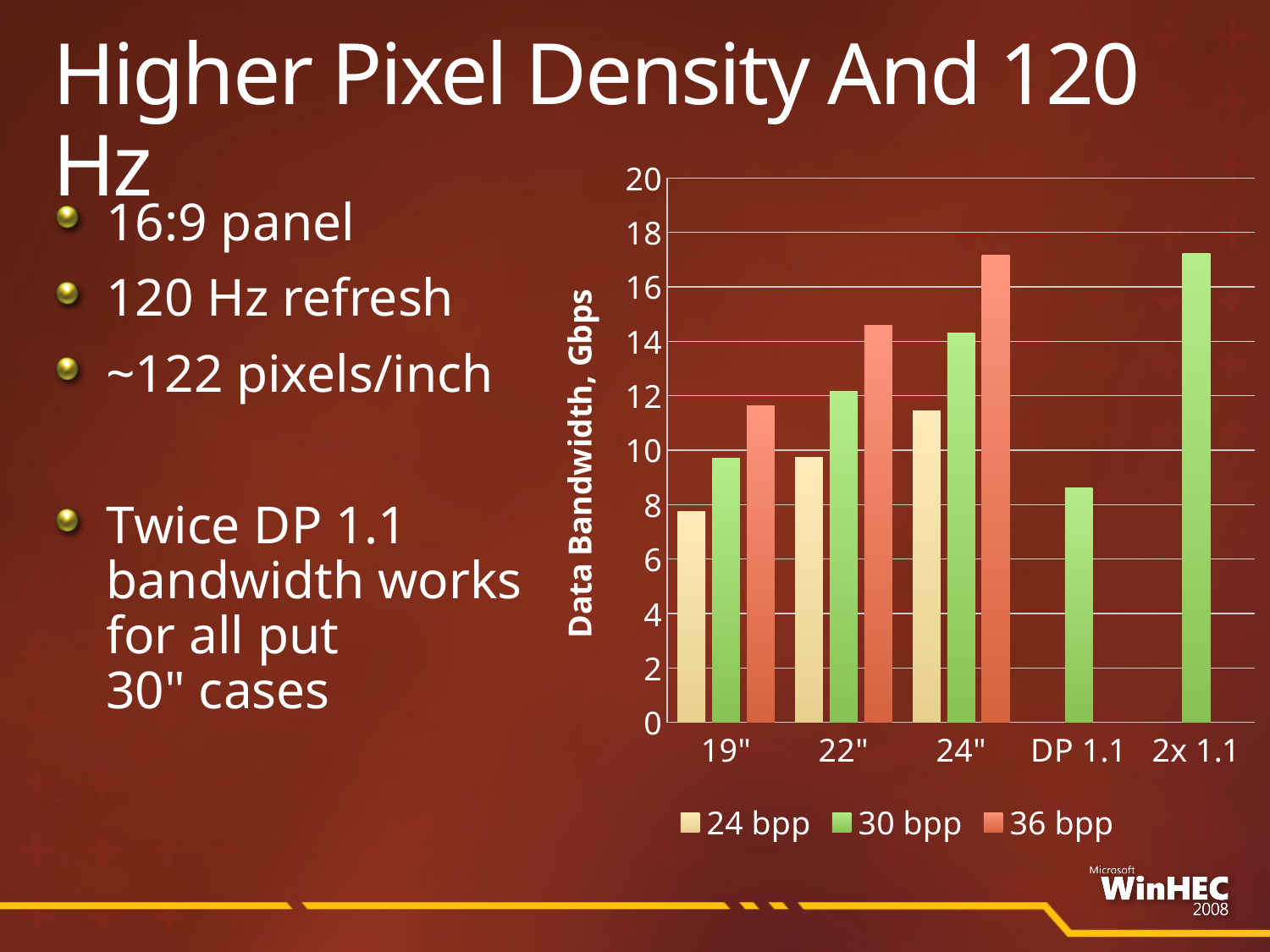
Which is larger: the 36 bpp value for 22" or the 24 bpp value for 24"? 36 bpp value for 22" Is the value for DP 1.1 greater or less than 10? less What is the title of the vertical axis of the chart? Data Bandwidth, Gbps How many series does the chart legend list? 3 Do the 36 bpp values rise or fall from 19" to 24"? rise Among the 19", 22" and 24" categories, which has the lowest 24 bpp value? 19" What kind of chart is shown on the slide? bar chart Which series in the chart is shown in green? 30 bpp Among the 19", 22" and 24" categories, which has the highest 36 bpp value? 24" Is the 36 bpp value for 24" greater or less than 16? greater How many categories are shown on the x axis of the chart? 5 Is the 24 bpp value for 19" greater or less than 10? less